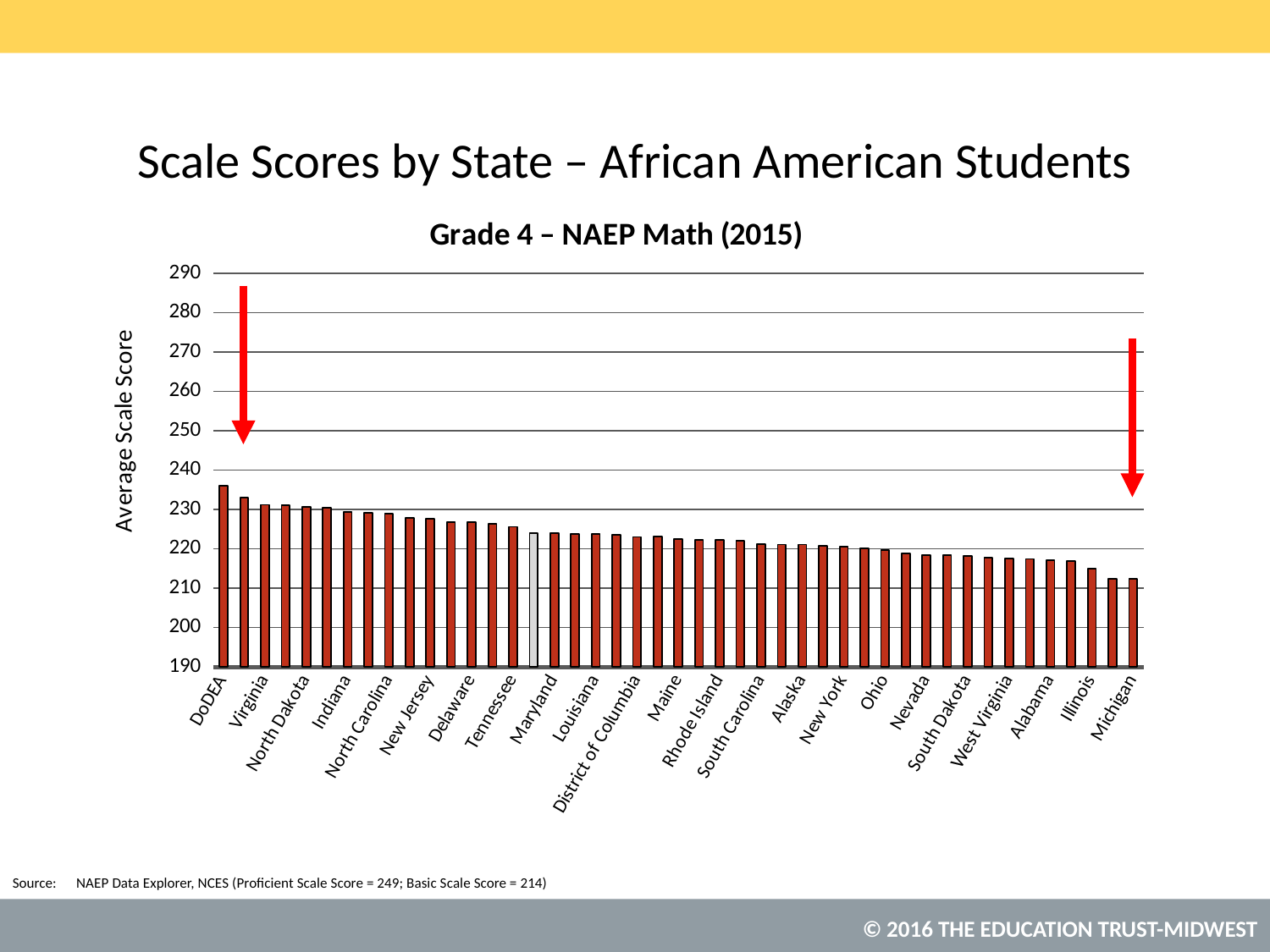
What is the label on the vertical axis of the chart? Average Scale Score Is the value for Tennessee greater or less than 230? less Is the value for Illinois greater or less than 220? less What kind of chart is shown on the slide? bar chart Which has the larger average scale score, Virginia or Illinois? Virginia Is the value for Maryland greater or less than 220? greater Which state or jurisdiction has the highest average scale score in the chart? DoDEA What is the title of the chart? Grade 4 – NAEP Math (2015) Which has the larger average scale score, DoDEA or Michigan? DoDEA Do the bars rise or fall moving from left to right along the x axis? fall